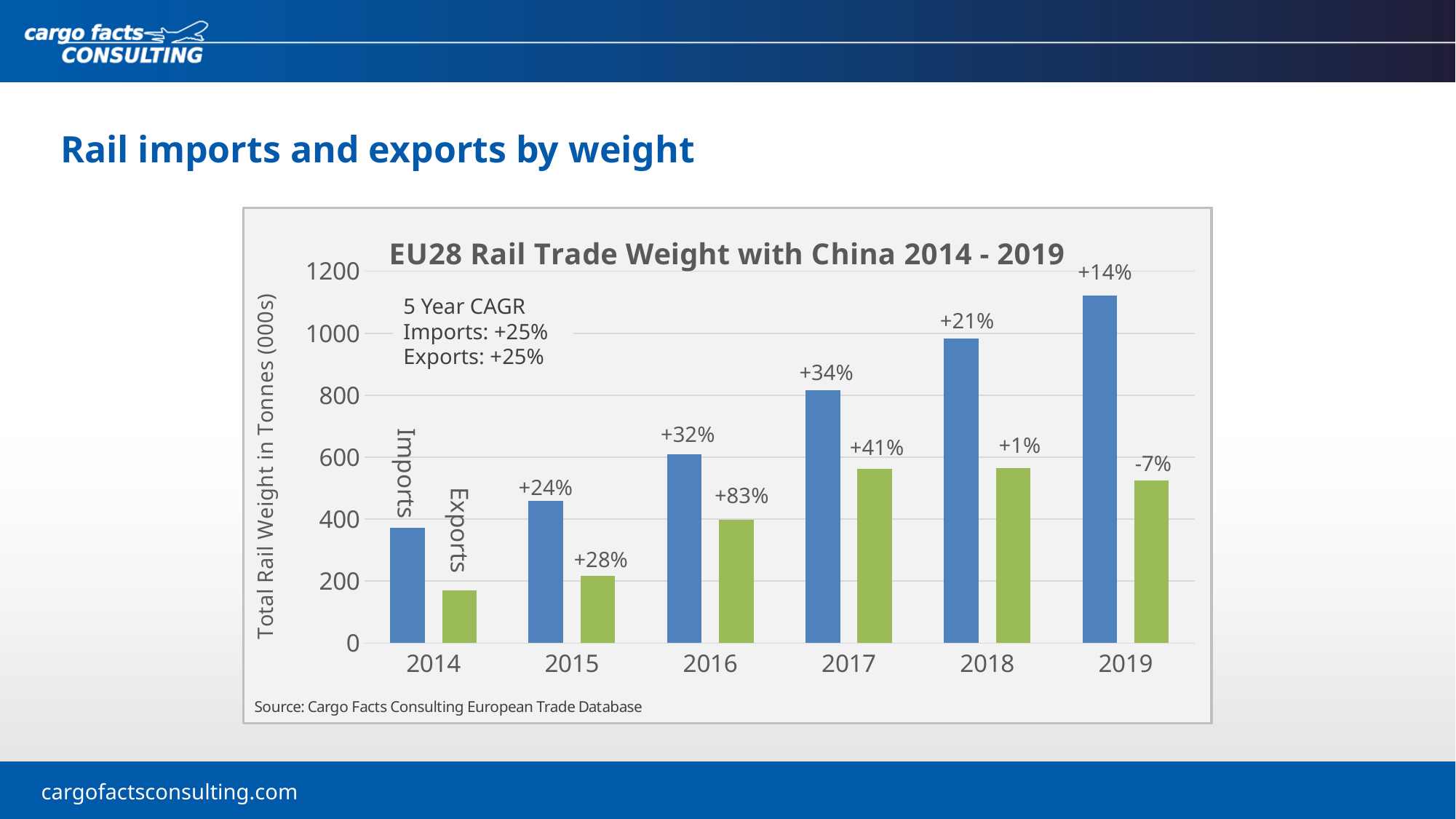
What growth percentage is labelled on the Imports bar for 2017? +34% How many data series does the chart show? 2 Is the Imports value for 2019 greater or less than 1000? greater In 2018, which is larger, Imports or Exports? Imports Is the Exports value for 2015 greater or less than 400? less What growth percentage is labelled on the Exports bar for 2016? +83% In which year is the Exports bar the lowest? 2014 What growth percentage is labelled on the Exports bar for 2019? -7% What is the 5 Year CAGR for Imports stated on the chart? +25% What kind of chart is shown on the slide? bar chart In which year is the Imports bar the highest? 2019 How many years are shown on the x axis of the chart? 6